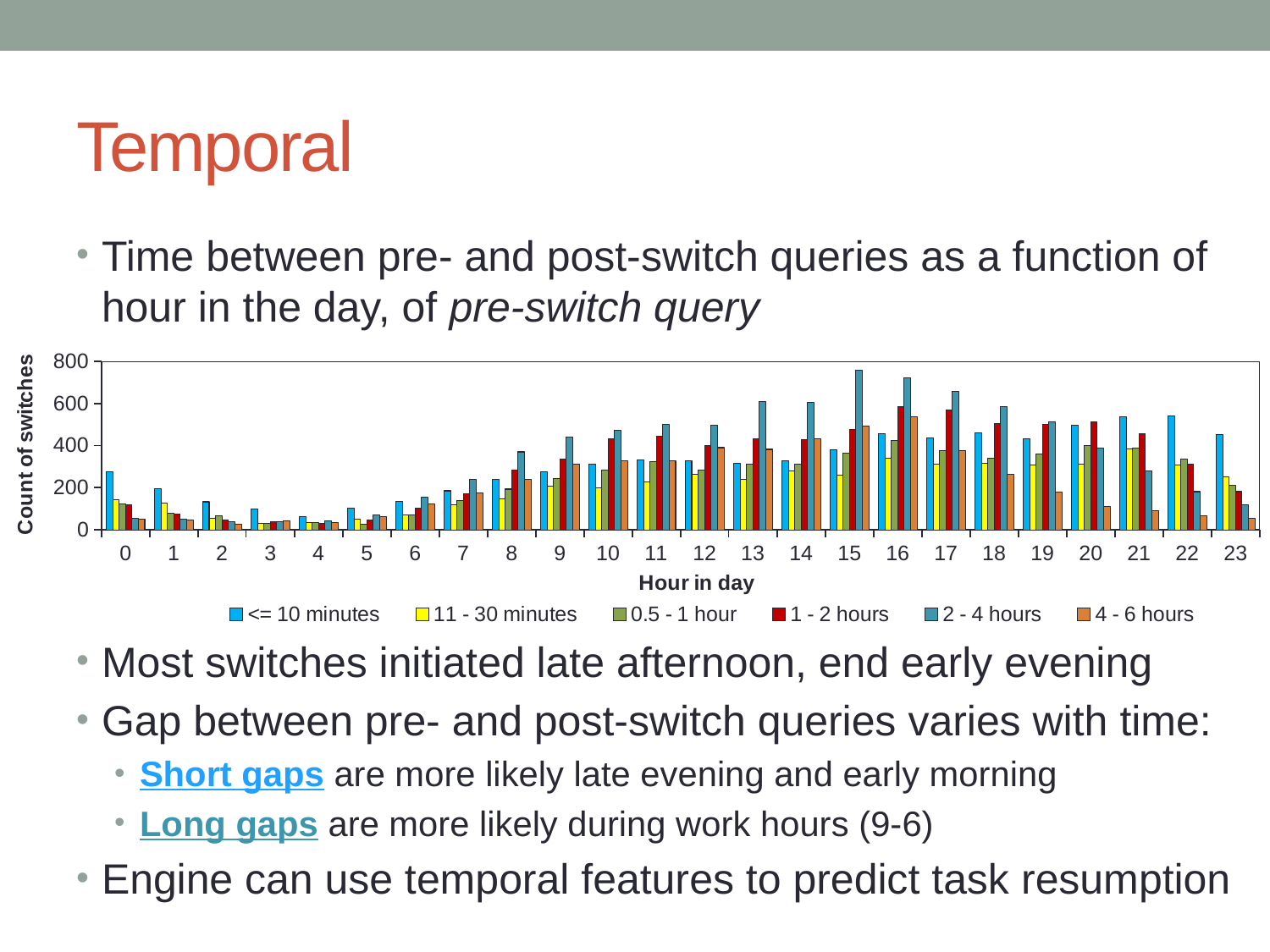
At hour 15, which series has the larger value: 2 - 4 hours or <= 10 minutes? 2 - 4 hours What kind of chart is shown on the slide? bar chart Is the value for the 4 - 6 hours series at hour 4 greater or less than 200? less How many series does the legend list? 6 Do the values for the <= 10 minutes series generally rise or fall from hour 4 to hour 15? rise How many hour categories are shown along the x axis? 24 For the <= 10 minutes series, which is larger: the value at hour 0 or the value at hour 4? hour 0 What is the title of the y axis? Count of switches Is the value for the 2 - 4 hours series at hour 15 greater or less than 600? greater Is the value for the <= 10 minutes series at hour 22 greater or less than 400? greater What is the title of the x axis? Hour in day